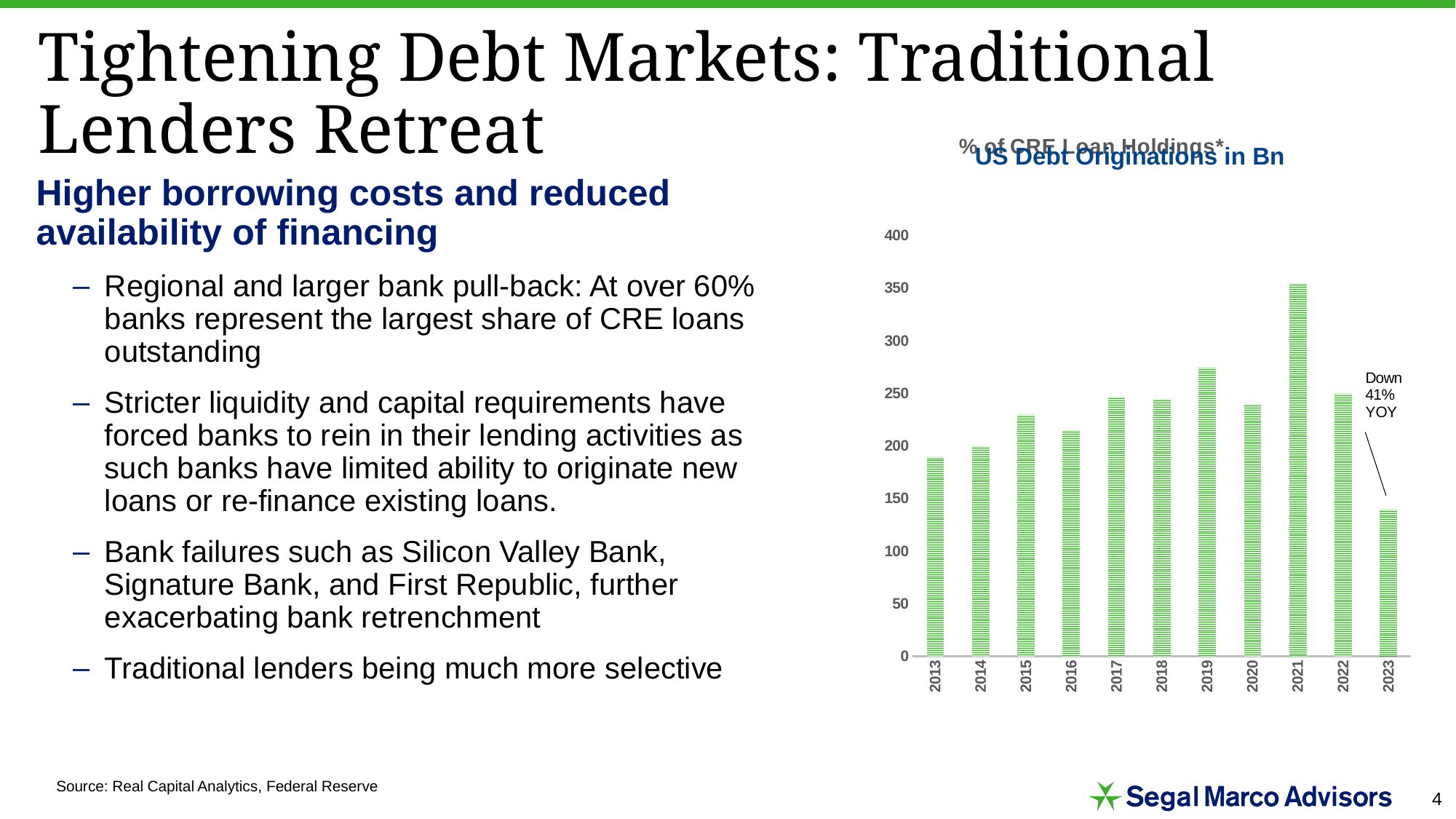
Which year has a higher value, 2021 or 2022? 2021 How many years are plotted in the US Debt Originations in Bn chart? 11 What kind of chart is shown on the slide? bar chart Is the value for 2019 greater or less than 250? greater What does the annotation next to the 2023 bar say? Down 41% YOY Which year has the highest US debt originations in the chart? 2021 Which year has a higher value, 2019 or 2020? 2019 Is the value for 2023 greater or less than 150? less Is the value for 2021 greater or less than 300? greater Do the values rise or fall from 2021 to 2023? fall Which year has the lowest US debt originations in the chart? 2023